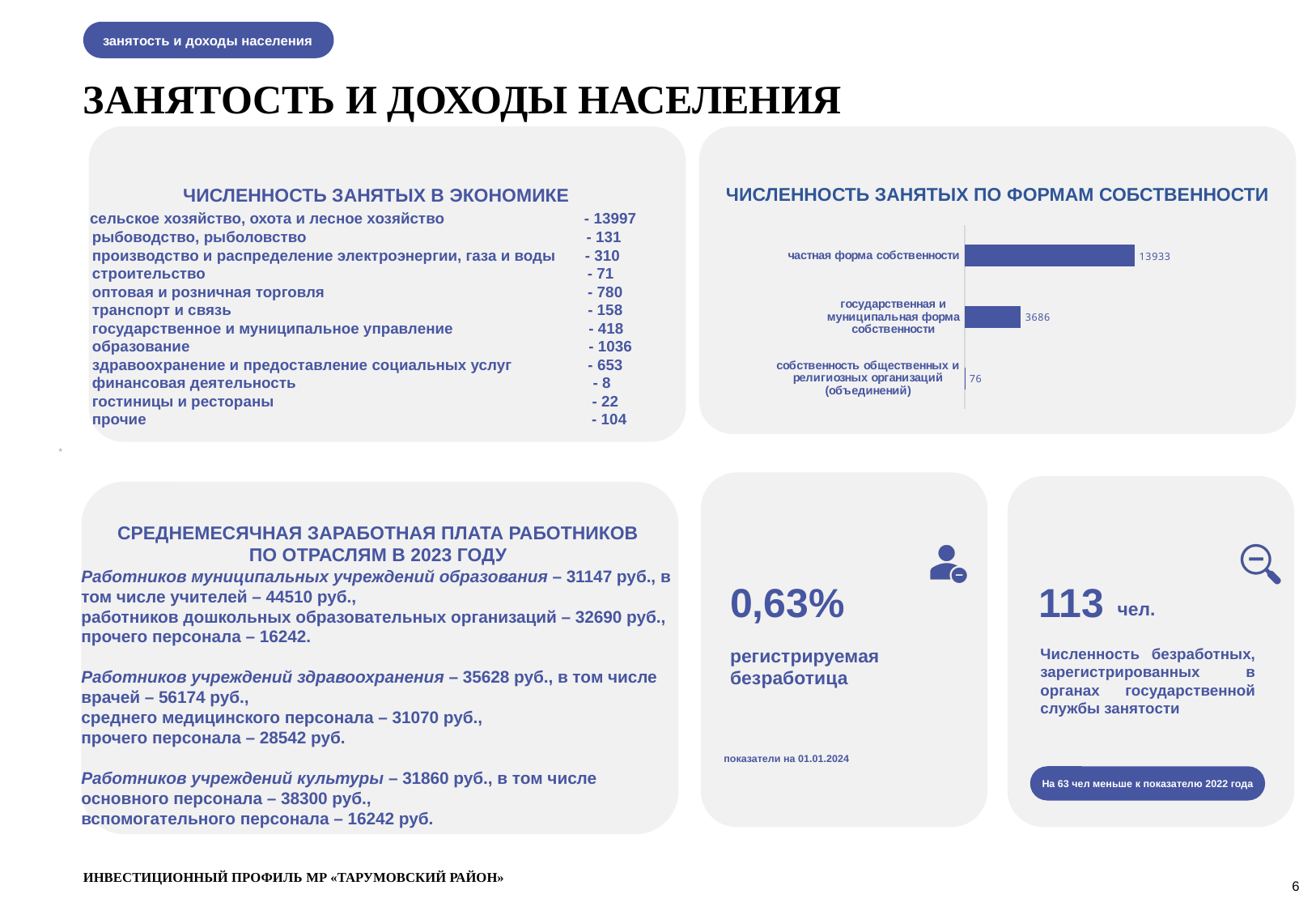
Какого цвета столбцы на диаграмме «Численность занятых по формам собственности»? синего На сколько численность занятых в государственной и муниципальной форме собственности больше, чем в собственности общественных и религиозных организаций? 3610 Какая форма собственности имеет наибольшую численность занятых на диаграмме? частная форма собственности Как называется диаграмма в правой верхней части слайда? ЧИСЛЕННОСТЬ ЗАНЯТЫХ ПО ФОРМАМ СОБСТВЕННОСТИ Какое значение показано для категории «частная форма собственности» на диаграмме «Численность занятых по формам собственности»? 13933 Сколько категорий (форм собственности) показано на диаграмме «Численность занятых по формам собственности»? 3 Что больше: численность занятых в государственной и муниципальной форме собственности или в собственности общественных и религиозных организаций? государственная и муниципальная форма собственности Какое значение показано для категории «государственная и муниципальная форма собственности»? 3686 Какая форма собственности имеет наименьшую численность занятых на диаграмме? собственность общественных и религиозных организаций (объединений) Какого типа диаграмма «Численность занятых по формам собственности»? столбчатая (горизонтальная) диаграмма На сколько численность занятых в частной форме собственности больше, чем в государственной и муниципальной? 10247 Какое значение показано для категории «собственность общественных и религиозных организаций (объединений)»? 76